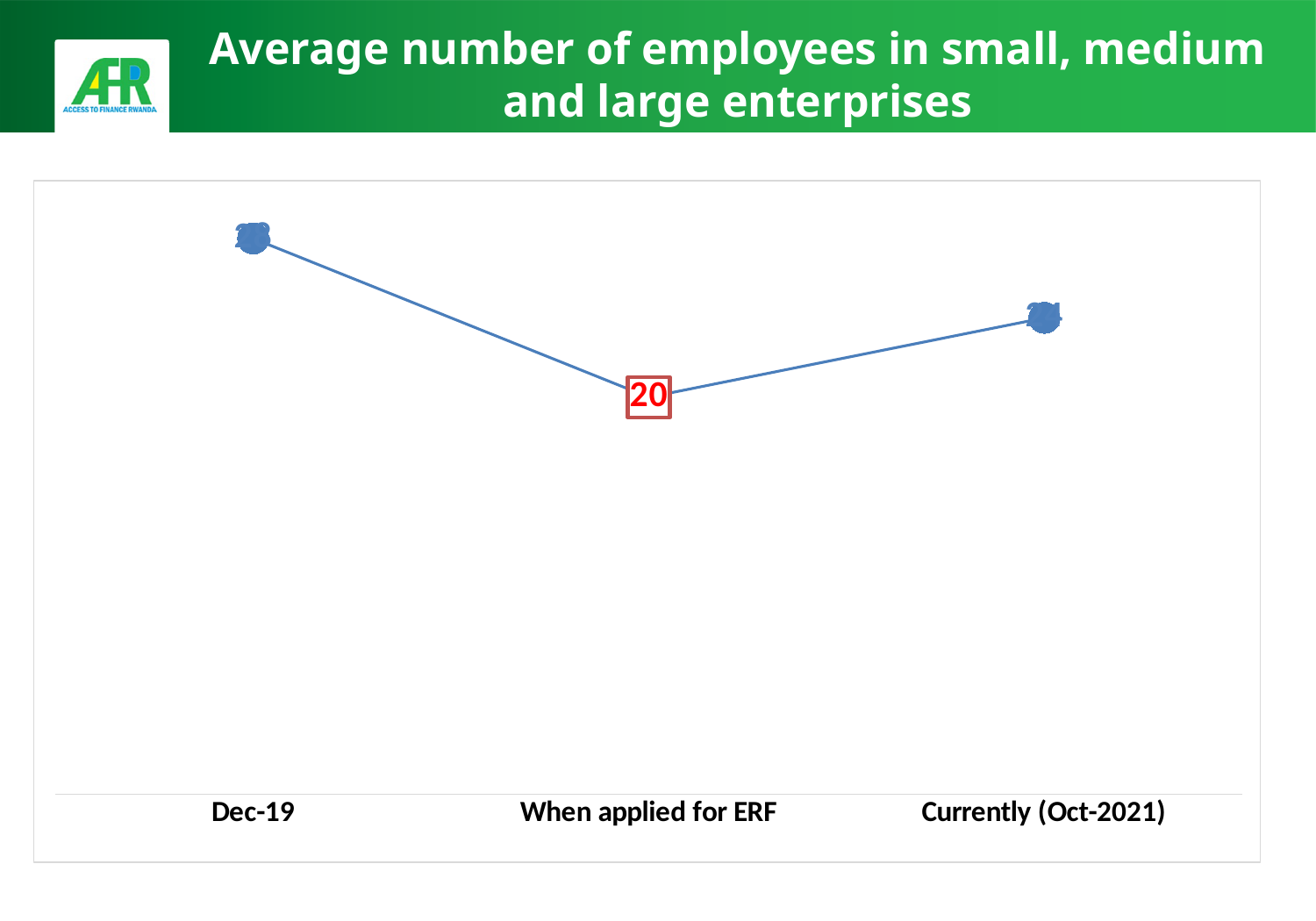
How does the average number of employees change from Dec-19 to Currently (Oct-2021)? It falls, then rises Which category has the highest average number of employees? Dec-19 What kind of chart is shown on the slide? Line chart Which is higher, the value for 'When applied for ERF' or the value for 'Currently (Oct-2021)'? Currently (Oct-2021) How many data points are plotted on the chart? 3 How many lines are plotted on the chart? 1 What is the title of the slide? Average number of employees in small, medium and large enterprises What is the average number of employees shown for 'When applied for ERF'? 20 Which is higher, the value for Dec-19 or the value for Currently (Oct-2021)? Dec-19 What is the label of the last category on the x axis? Currently (Oct-2021) Which category has the lowest average number of employees? When applied for ERF